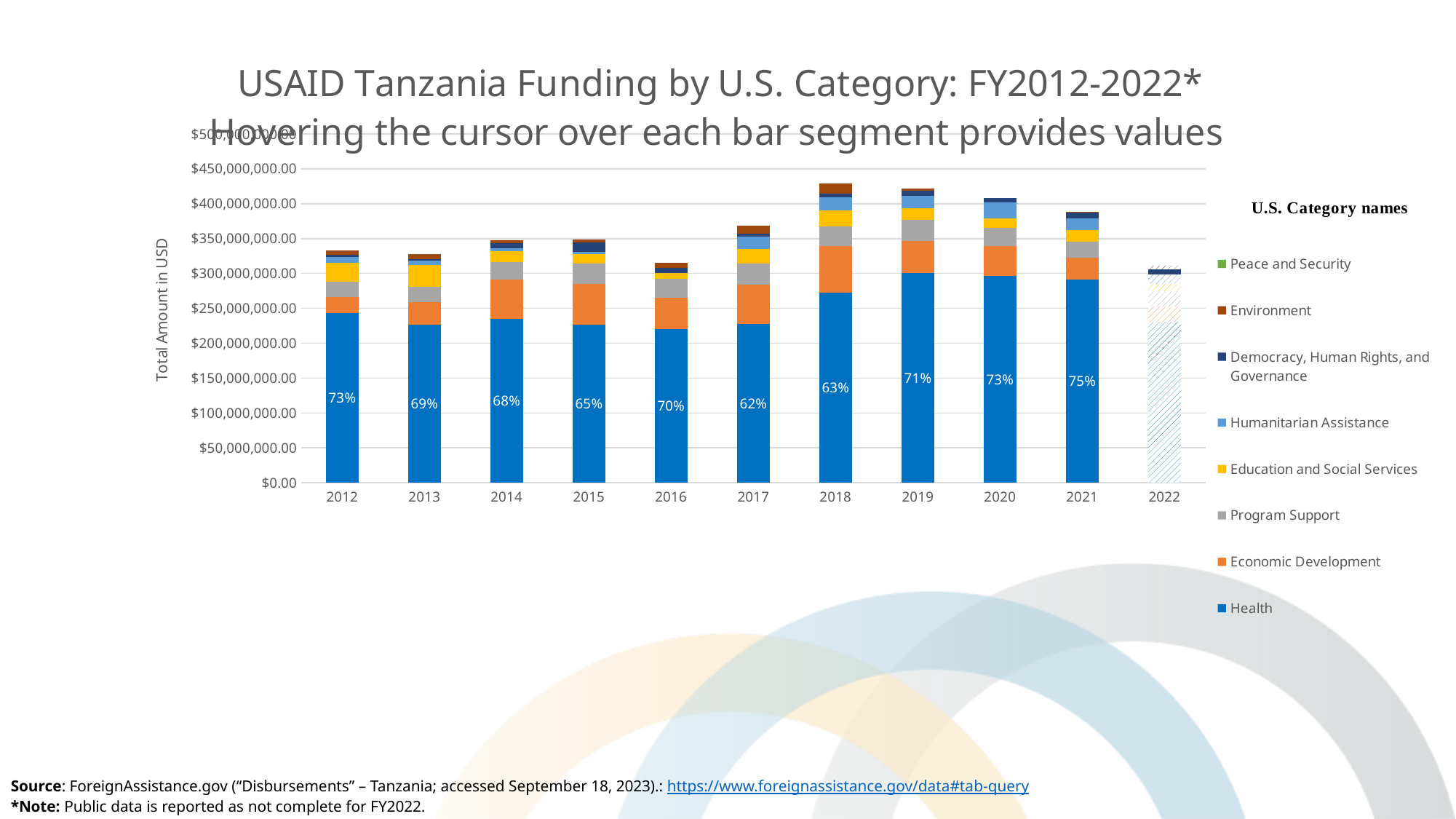
How many categories does the legend list? 8 What percentage label is shown on the Health segment for 2017? 62% Is the total stacked bar for 2016 greater or less than $350,000,000.00? less What is the difference between the Health percentage labels for 2021 and 2017? 13 percentage points How many years are shown on the x axis? 11 Which year has a larger Health percentage label, 2018 or 2019? 2019 Which year has the lowest Health percentage label? 2017 What type of chart is shown on the slide? Stacked bar chart What percentage label is shown on the Health segment for 2012? 73% Is the total stacked bar for 2018 greater or less than $400,000,000.00? greater What percentage label is shown on the Health segment for 2021? 75% Which year has the highest Health percentage label? 2021